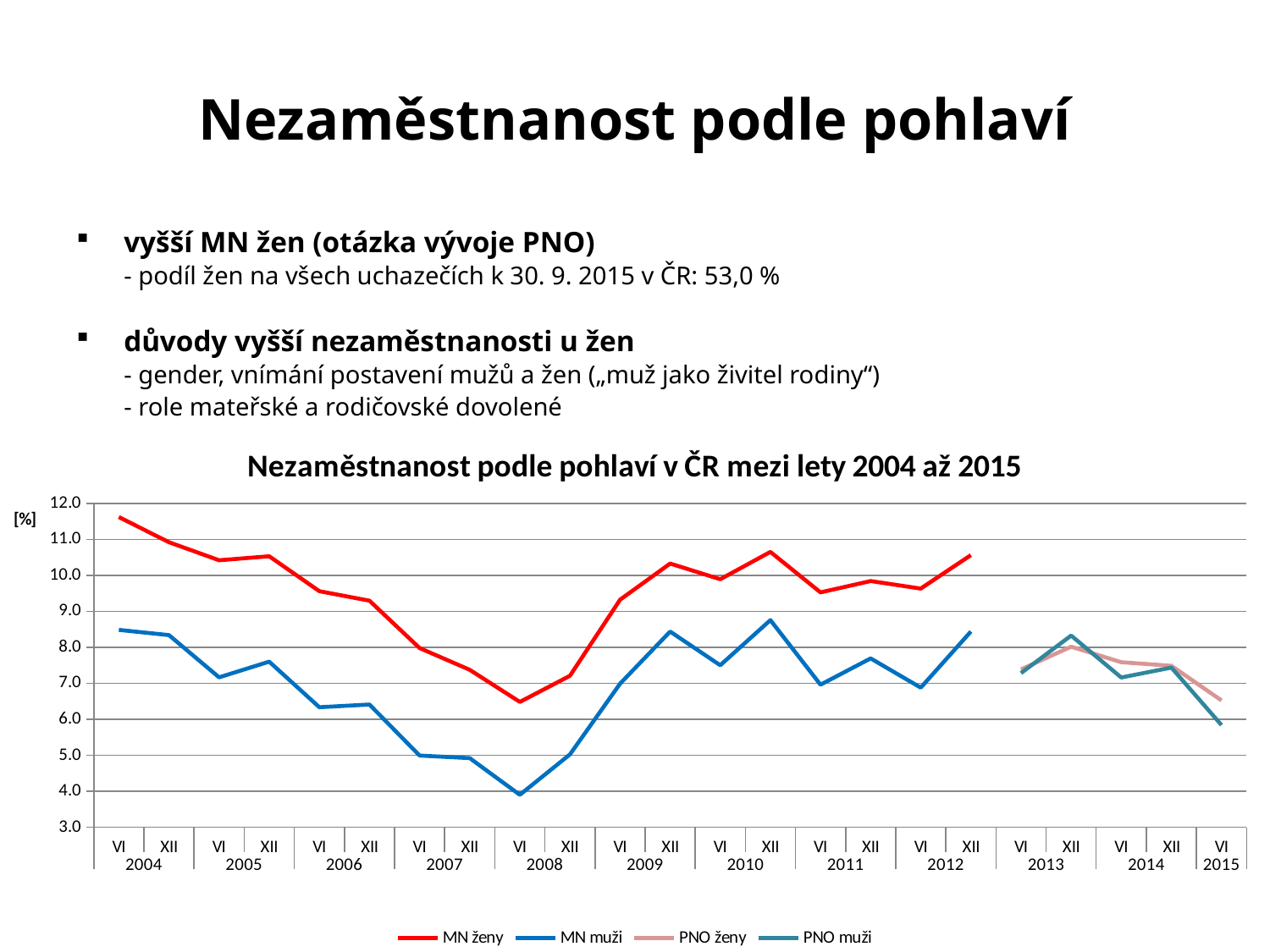
At which point on the x axis is the MN ženy series highest? VI 2004 What kind of chart is shown on the slide? line chart At which point on the x axis is the MN ženy series lowest? VI 2008 Which colour is used for the MN ženy series? red What is the title of the chart? Nezaměstnanost podle pohlaví v ČR mezi lety 2004 až 2015 Is the value of PNO ženy at VI 2015 greater or less than 6.0? greater Is the value of MN ženy at VI 2004 greater or less than 11.0? greater At XII 2010, which series has the higher value, MN ženy or MN muži? MN ženy How many years are labelled on the x axis of the chart? 12 Does the MN muži series rise or fall between VI 2008 and XII 2009? rise How many series does the chart legend list? 4 Is the value of MN muži at VI 2008 greater or less than 5.0? less